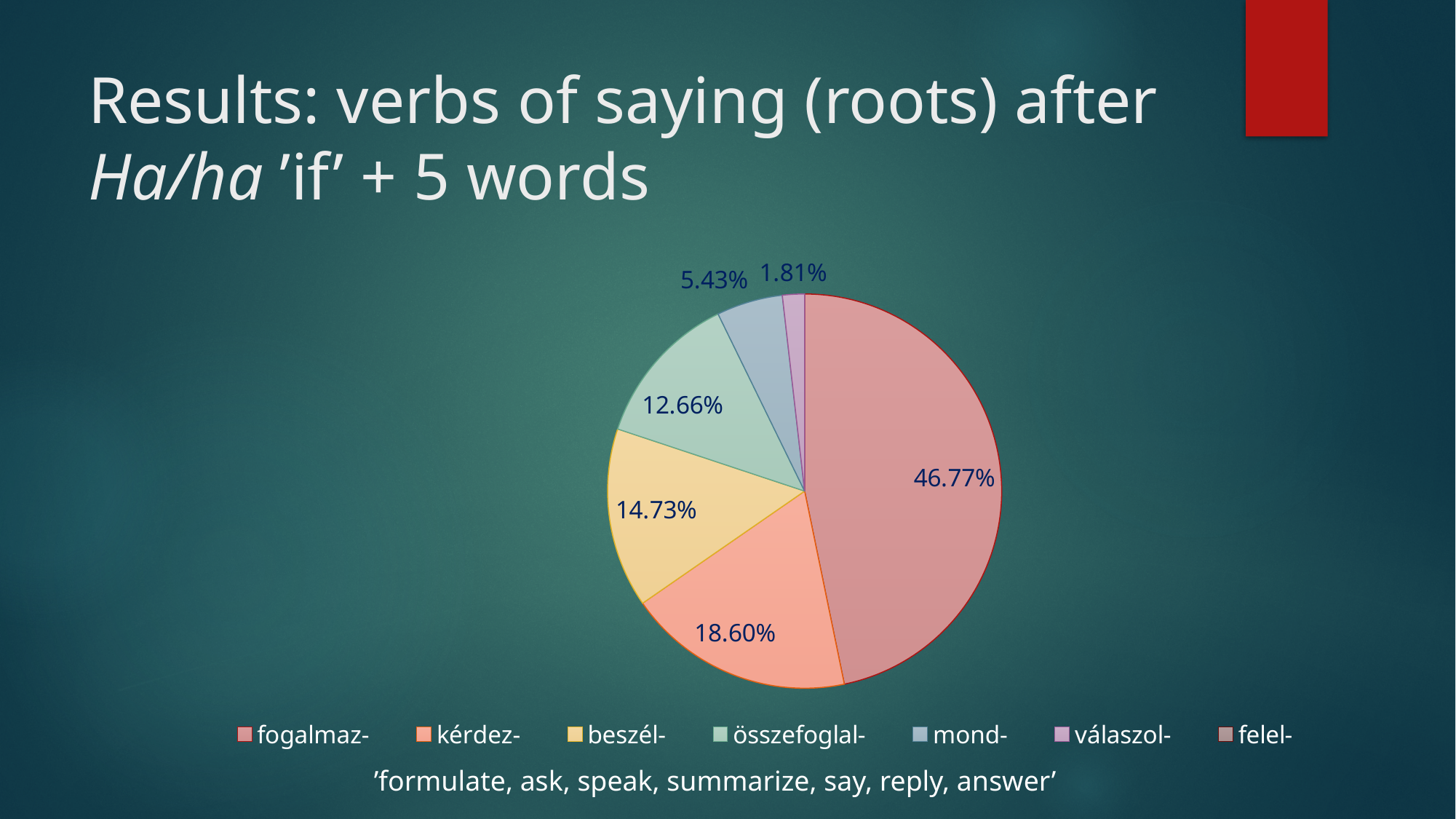
What type of chart is shown on the slide? pie chart What is the title of the slide containing the chart? Results: verbs of saying (roots) after Ha/ha 'if' + 5 words Which verb root has the largest slice of the pie? fogalmaz- What is the value shown for beszél-? 14.73% Which has a larger share, beszél- or összefoglal-? beszél- What is the value shown for mond-? 5.43% What is the value shown for válaszol-? 1.81% What is the value shown for kérdez-? 18.60% What is the difference in percentage points between fogalmaz- and kérdez-? 28.17 What is the value shown for összefoglal-? 12.66% What percentage of the pie does fogalmaz- account for? 46.77% How many verb roots are listed in the legend? 7